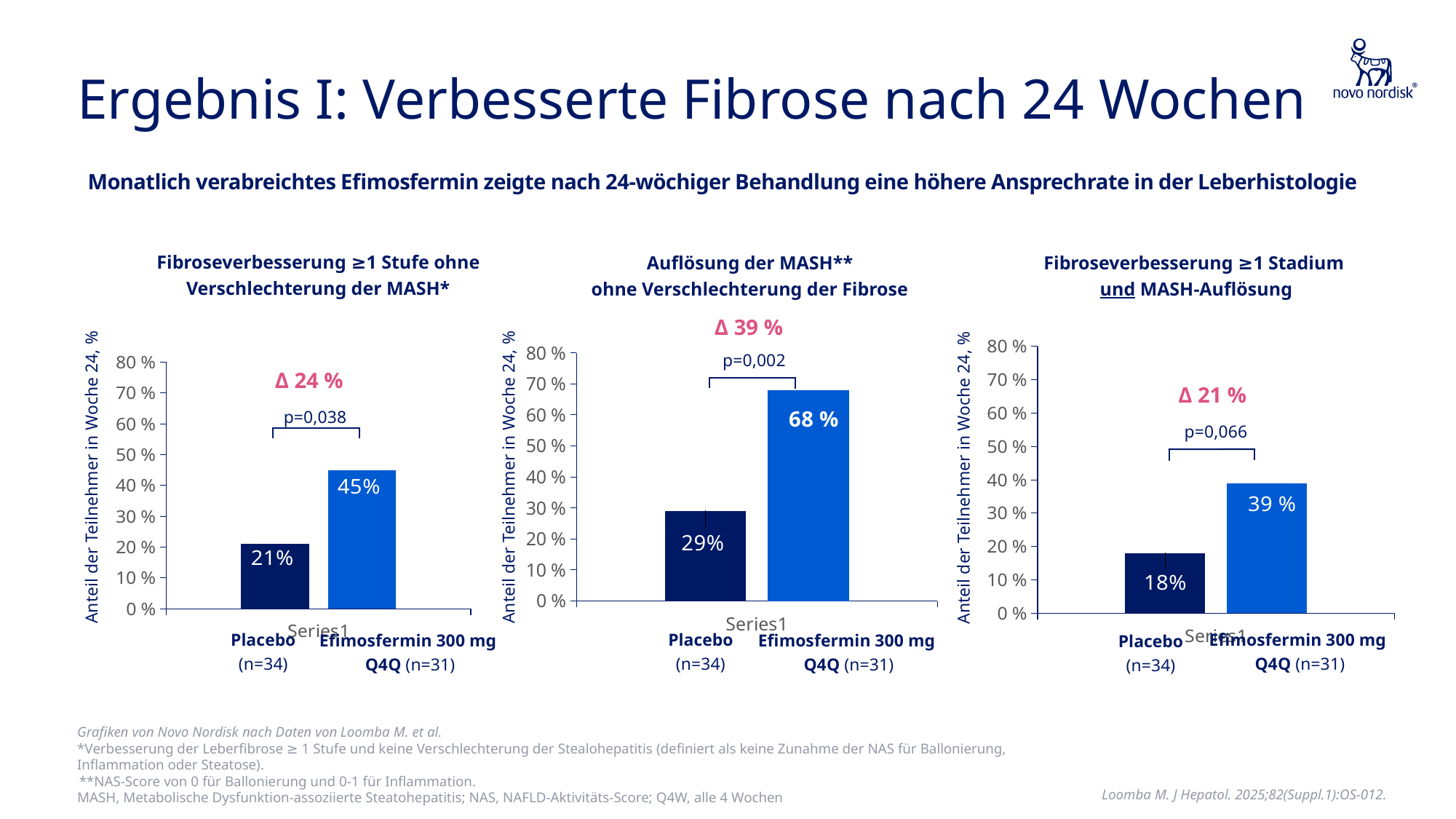
In the right chart (Fibroseverbesserung ≥1 Stadium und MASH-Auflösung), what is the value for Placebo? 18% In the middle chart (Auflösung der MASH** ohne Verschlechterung der Fibrose), is the value for Placebo greater or less than 30 %? less In the left chart (Fibroseverbesserung ≥1 Stufe ohne Verschlechterung der MASH*), what is the difference between the Efimosfermin 300 mg Q4Q value and the Placebo value? 24 % What kind of chart is the left chart (Fibroseverbesserung ≥1 Stufe ohne Verschlechterung der MASH*)? bar chart In the right chart (Fibroseverbesserung ≥1 Stadium und MASH-Auflösung), what is the value for Efimosfermin 300 mg Q4Q? 39 % In the middle chart (Auflösung der MASH** ohne Verschlechterung der Fibrose), which group has the higher value? Efimosfermin 300 mg Q4Q In the left chart (Fibroseverbesserung ≥1 Stufe ohne Verschlechterung der MASH*), what is the value for Efimosfermin 300 mg Q4Q? 45% In the right chart (Fibroseverbesserung ≥1 Stadium und MASH-Auflösung), which group has the lowest value? Placebo In the middle chart (Auflösung der MASH** ohne Verschlechterung der Fibrose), what is the value for Efimosfermin 300 mg Q4Q? 68 % In the middle chart (Auflösung der MASH** ohne Verschlechterung der Fibrose), what is the value for Placebo? 29% How many bars are shown in the right chart (Fibroseverbesserung ≥1 Stadium und MASH-Auflösung)? 2 In the left chart (Fibroseverbesserung ≥1 Stufe ohne Verschlechterung der MASH*), what is the value for Placebo? 21%